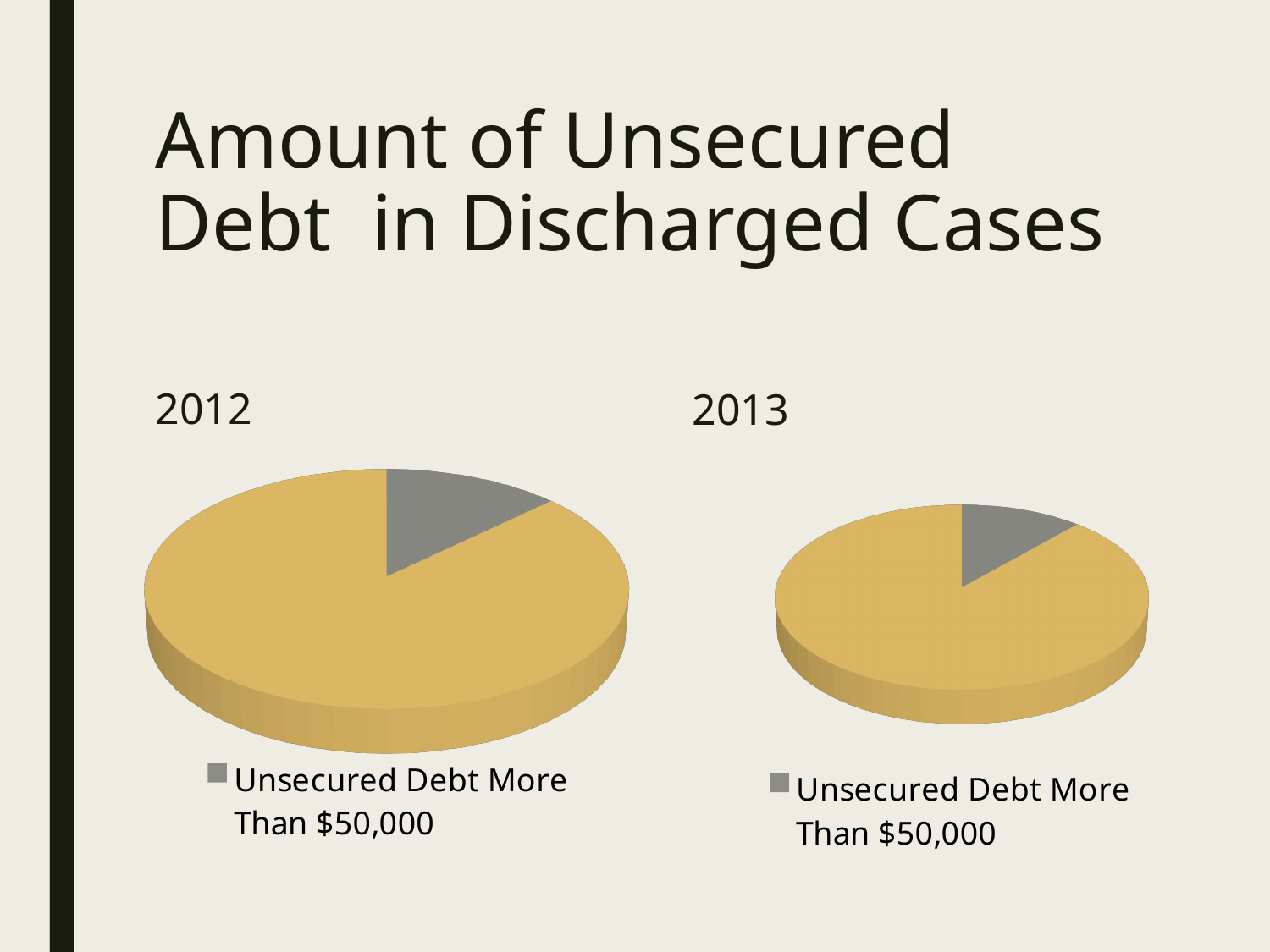
In the 2013 chart, is the slice for Unsecured Debt More Than $50,000 larger or smaller than the other slice? smaller In the 2012 chart, is the slice for Unsecured Debt More Than $50,000 larger or smaller than the other slice? smaller How many entries does the legend of the 2013 chart list? 1 What is the legend entry shown for the 2013 chart? Unsecured Debt More Than $50,000 What kind of chart is the 2012 chart? pie chart What colour is the Unsecured Debt More Than $50,000 slice in the 2012 chart? grey How many slices does the 2012 pie chart have? 2 In the 2013 chart, which slice is the smallest? Unsecured Debt More Than $50,000 How many slices does the 2013 pie chart have? 2 What kind of chart is the 2013 chart? pie chart In the 2012 chart, which slice is the largest? the unlabelled gold slice How many entries does the legend of the 2012 chart list? 1